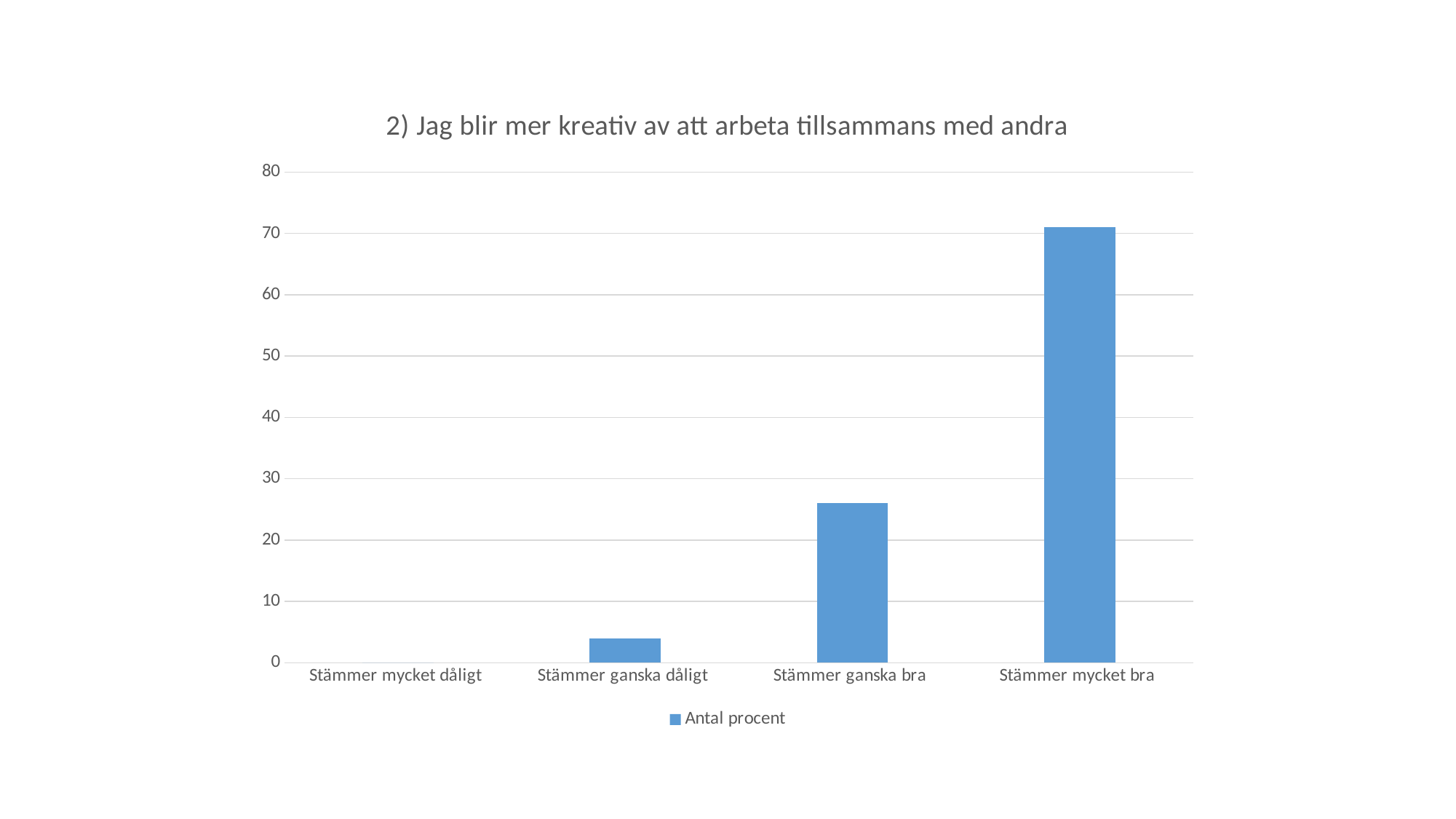
What is the name of the series shown in the legend? Antal procent Which category has the lowest value? Stämmer mycket dåligt How many series does the legend list? 1 What is the title of the chart? 2) Jag blir mer kreativ av att arbeta tillsammans med andra Is the value for Stämmer ganska bra greater or less than 30? less Do the values rise or fall from left to right along the x axis? rise Is the value for Stämmer ganska dåligt greater or less than 10? less What kind of chart is shown on the slide? bar chart How many categories are shown on the x axis? 4 Which category has the highest value? Stämmer mycket bra Which is larger, the value for Stämmer ganska bra or the value for Stämmer ganska dåligt? Stämmer ganska bra